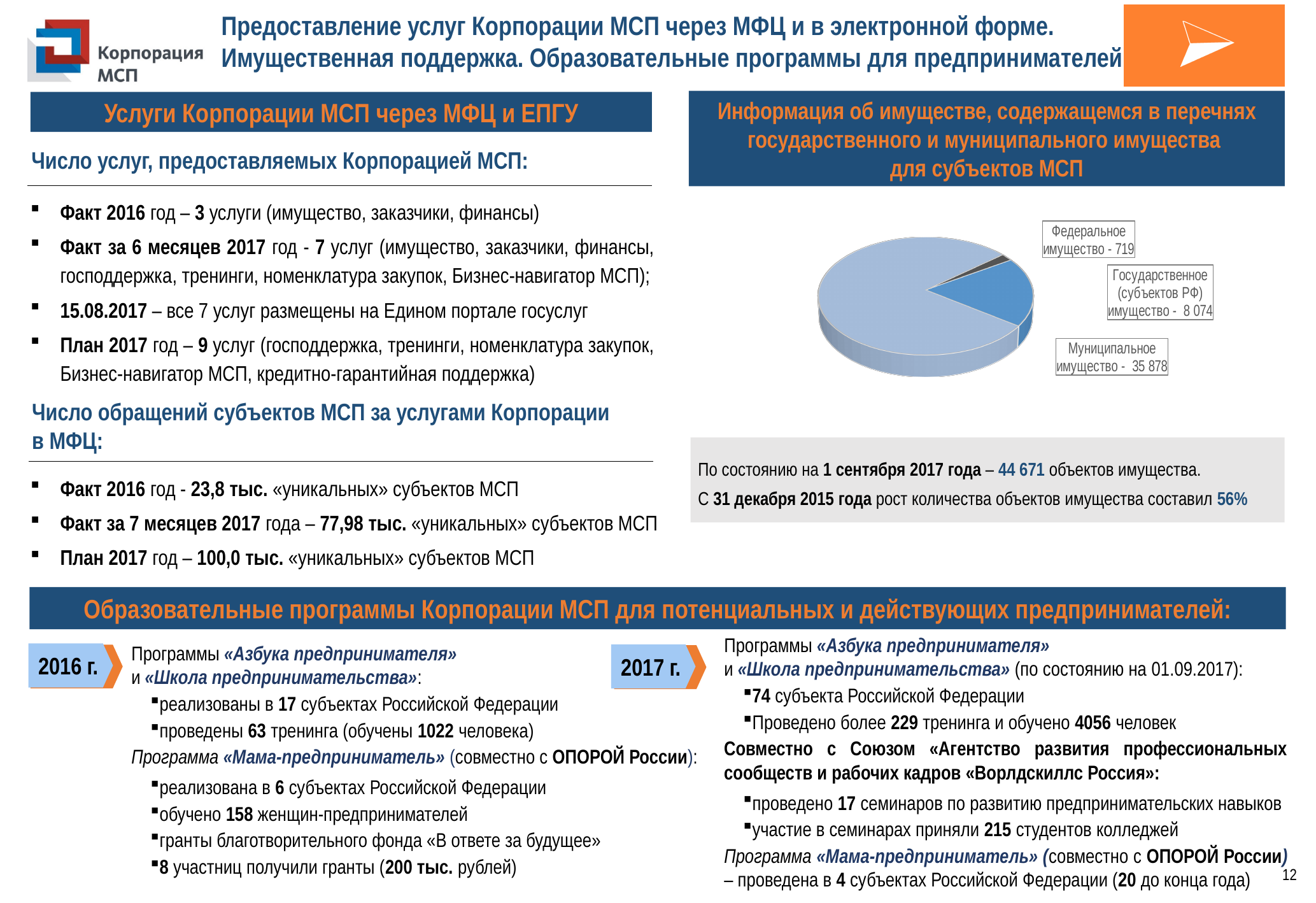
How many slices does the pie chart have? 3 What is the value for Государственное (субъектов РФ) имущество in the pie chart? 8 074 Which category has the largest slice in the pie chart? Муниципальное имущество What is the difference between Государственное (субъектов РФ) имущество and Федеральное имущество in the pie chart? 7 355 What is the title of the section containing the pie chart? Информация об имуществе, содержащемся в перечнях государственного и муниципального имущества для субъектов МСП Which category has the smallest slice in the pie chart? Федеральное имущество Which is larger in the pie chart: Государственное (субъектов РФ) имущество or Федеральное имущество? Государственное (субъектов РФ) имущество What is the total of all three slices in the pie chart? 44 671 What type of chart is shown on the slide? pie chart What is the value for Федеральное имущество in the pie chart? 719 What is the value for Муниципальное имущество in the pie chart? 35 878 What is the difference between Муниципальное имущество and Государственное (субъектов РФ) имущество in the pie chart? 27 804